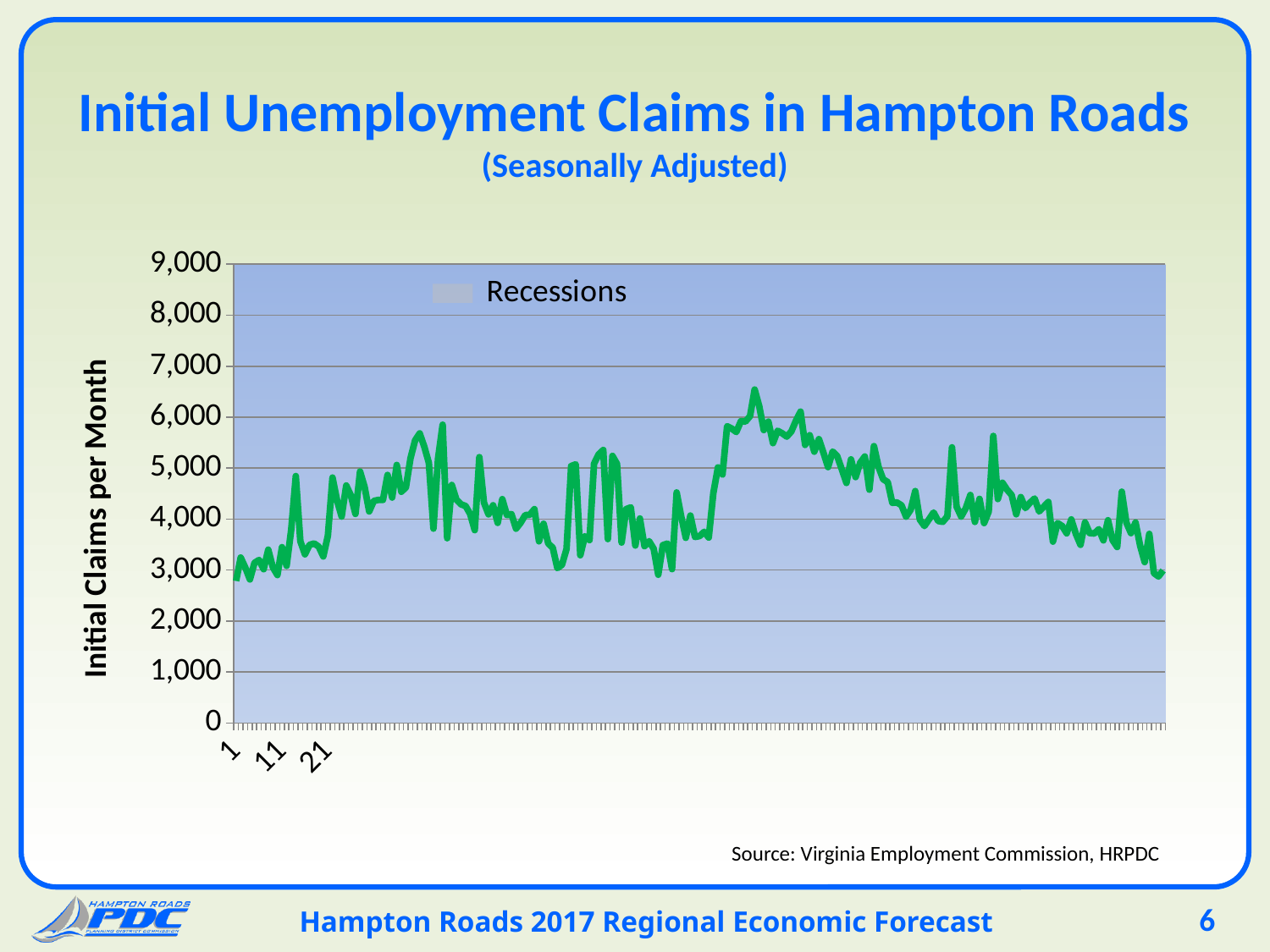
Is the value at the last point on the line greater or less than 4,000? less Is the highest point on the line greater or less than 7,000? less What is the title of the chart on the slide? Initial Unemployment Claims in Hampton Roads (Seasonally Adjusted) How many entries does the chart's legend list? 1 Is the lowest point on the line greater or less than 2,000? greater What kind of chart is shown on the slide? line chart What is the label on the vertical axis of the chart? Initial Claims per Month